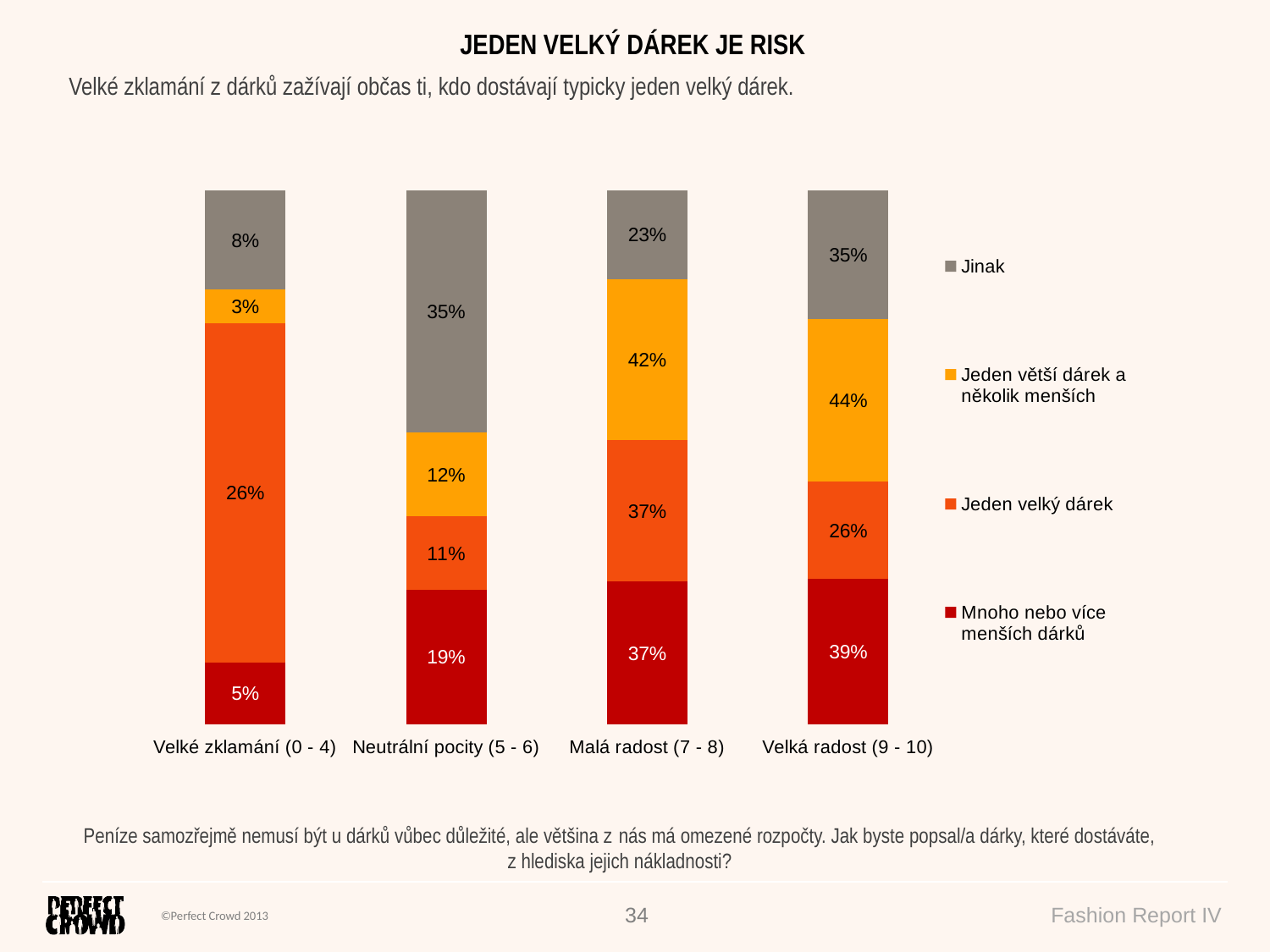
What is the value of 'Mnoho nebo více menších dárků' for the category 'Velká radost (9 - 10)'? 39% Which category has the larger 'Jeden velký dárek' value: 'Malá radost (7 - 8)' or 'Velká radost (9 - 10)'? Malá radost (7 - 8) What is the difference between the 'Jinak' value for 'Velká radost (9 - 10)' and for 'Velké zklamání (0 - 4)'? 27% What is the value of 'Jeden větší dárek a několik menších' for the category 'Malá radost (7 - 8)'? 42% What is the value of 'Jeden větší dárek a několik menších' for the category 'Velké zklamání (0 - 4)'? 3% How many series does the legend list? 4 What is the value of 'Jinak' for the category 'Neutrální pocity (5 - 6)'? 35% How many categories are shown on the x axis of the chart? 4 Which category has the highest value for 'Jeden větší dárek a několik menších'? Velká radost (9 - 10) What type of chart is shown on the slide? Stacked bar chart Which category has the lowest value for 'Mnoho nebo více menších dárků'? Velké zklamání (0 - 4) What is the value of 'Jeden velký dárek' for the category 'Velké zklamání (0 - 4)'? 26%